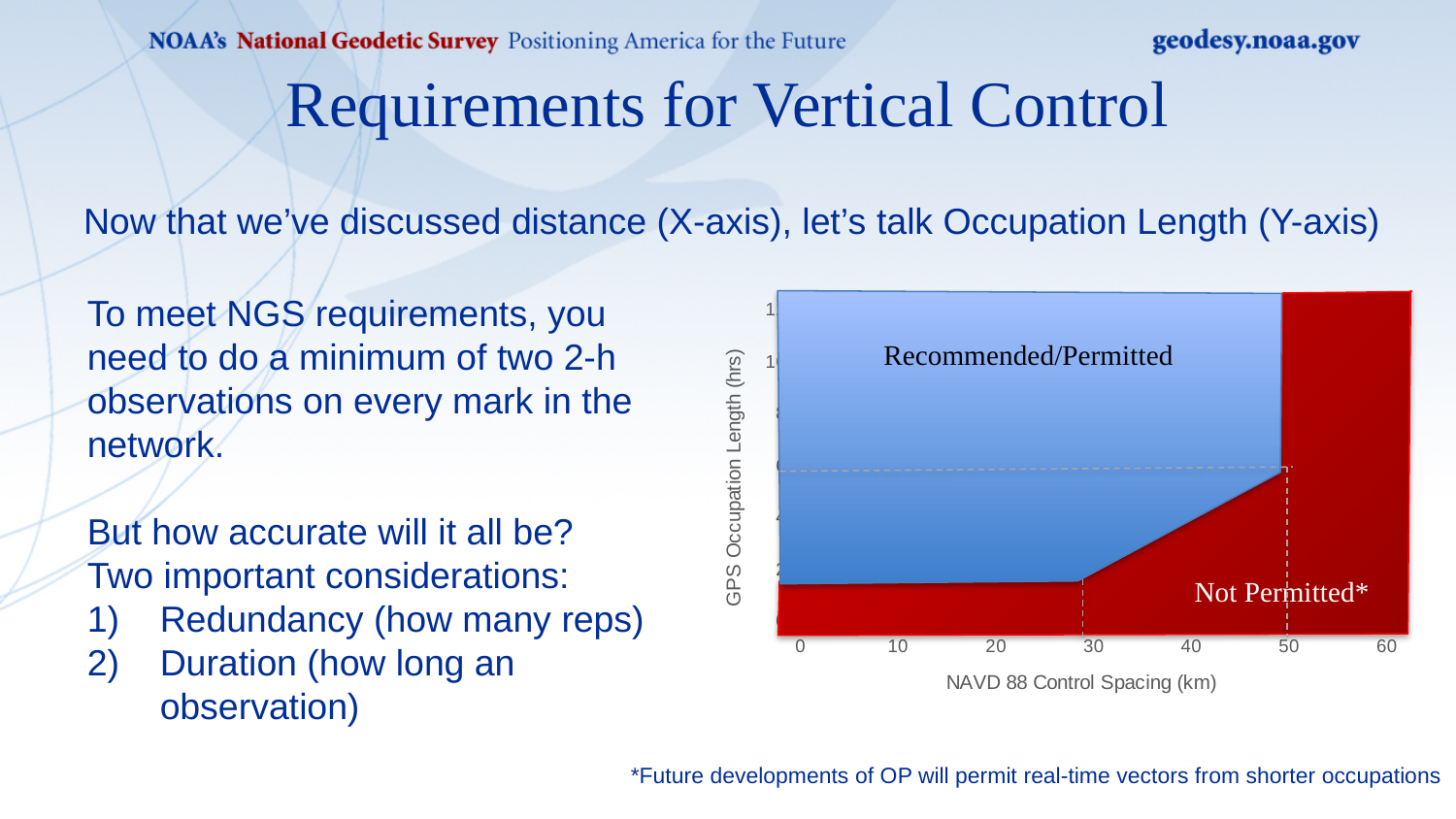
What kind of chart is shown on the slide? Area chart Is the control spacing at which the boundary between the regions starts to rise greater or less than 20 km? greater How many tick labels are shown on the x-axis of the chart? 7 As NAVD 88 control spacing increases from 30 km to 50 km, does the minimum required GPS occupation length rise or fall? Rise What is the highest tick value shown on the x-axis? 60 What are the two regions of the chart labelled? Recommended/Permitted and Not Permitted* At what NAVD 88 control spacing does the Not Permitted region extend over the full height of the chart? 50 What is the title of the x-axis of the chart? NAVD 88 Control Spacing (km) Which region covers a larger area of the chart, Recommended/Permitted or Not Permitted*? Recommended/Permitted